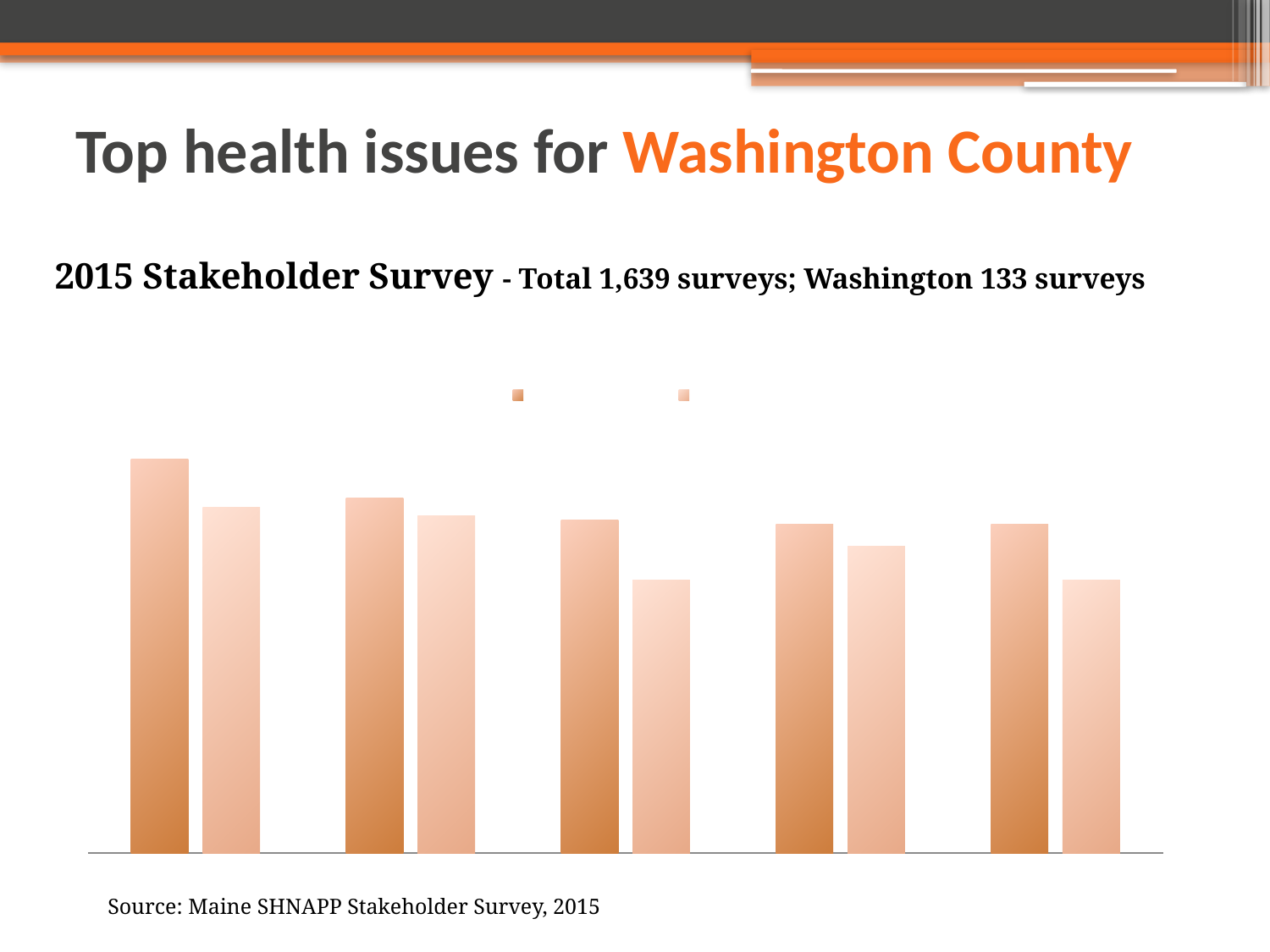
In the third group of bars from the left, is the darker bar or the lighter bar taller? the darker bar Is the darker bar in the first group taller or shorter than the darker bar in the second group? taller In the leftmost group of bars, is the darker bar or the lighter bar taller? the darker bar Which group of bars, counting from the left, contains the tallest bar in the chart? the first (leftmost) group How many groups of bars are plotted in the chart? 5 What is the source cited below the chart? Maine SHNAPP Stakeholder Survey, 2015 What kind of chart is shown on the slide? bar chart According to the slide, how many surveys were completed in Washington County? 133 How many series does the chart's legend list? 2